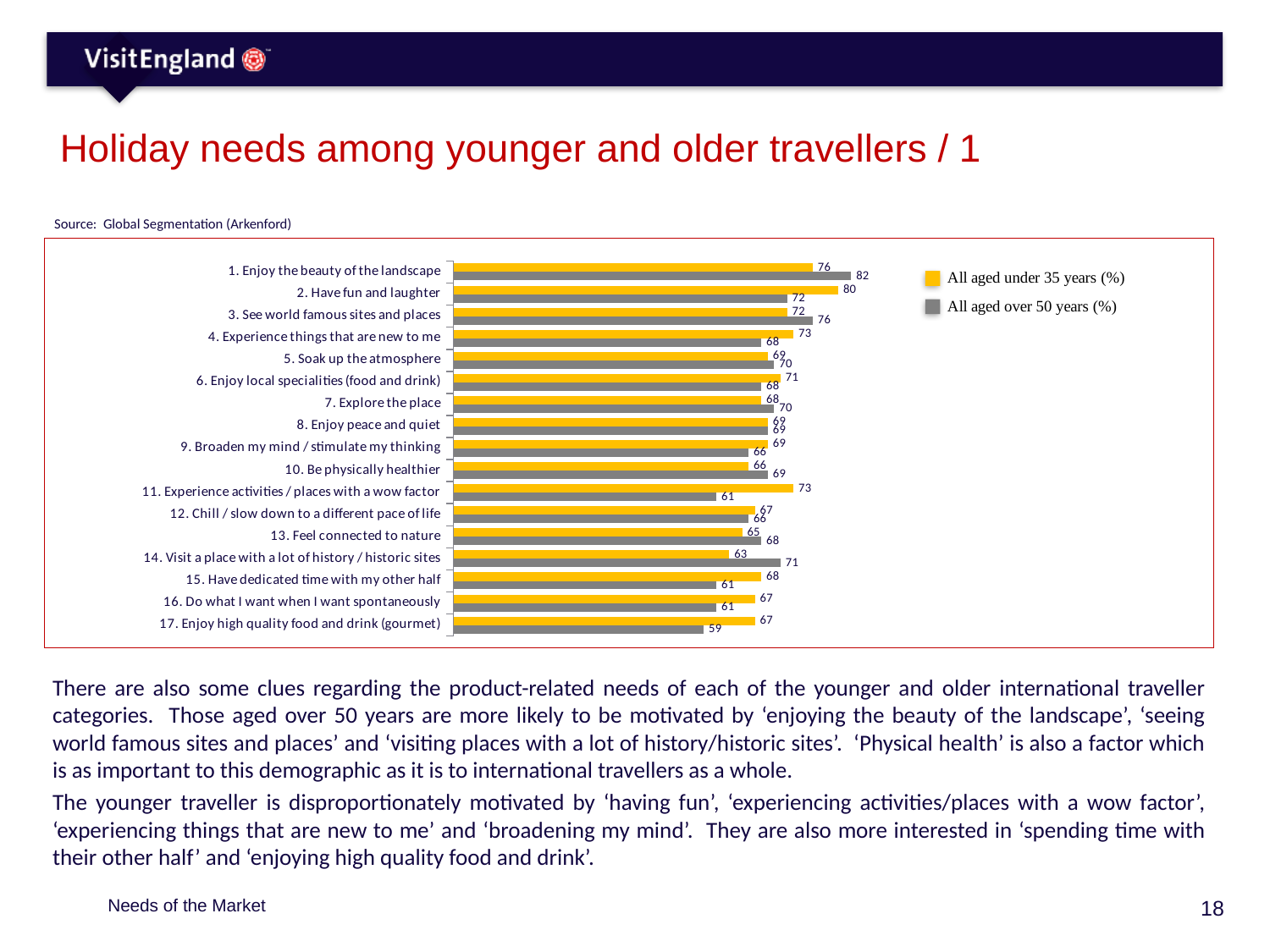
Which category has the lowest value for 'All aged over 50 years (%)'? 17. Enjoy high quality food and drink (gourmet) What is the value for 'All aged over 50 years (%)' for '17. Enjoy high quality food and drink (gourmet)'? 59 What kind of chart is shown on the slide? Bar chart For '14. Visit a place with a lot of history / historic sites', which series has the larger value: 'All aged under 35 years (%)' or 'All aged over 50 years (%)'? All aged over 50 years (%) What is the value for 'All aged under 35 years (%)' for '2. Have fun and laughter'? 80 How many series does the legend list? 2 Which category has the highest value for 'All aged under 35 years (%)'? 2. Have fun and laughter What is the difference between the over 50 and under 35 values for '1. Enjoy the beauty of the landscape'? 6 Which colour represents 'All aged over 50 years (%)' in the chart? Grey How many holiday needs (categories) are plotted on the chart? 17 What is the difference between the under 35 and over 50 values for '11. Experience activities / places with a wow factor'? 12 What is the value for 'All aged over 50 years (%)' for '1. Enjoy the beauty of the landscape'? 82